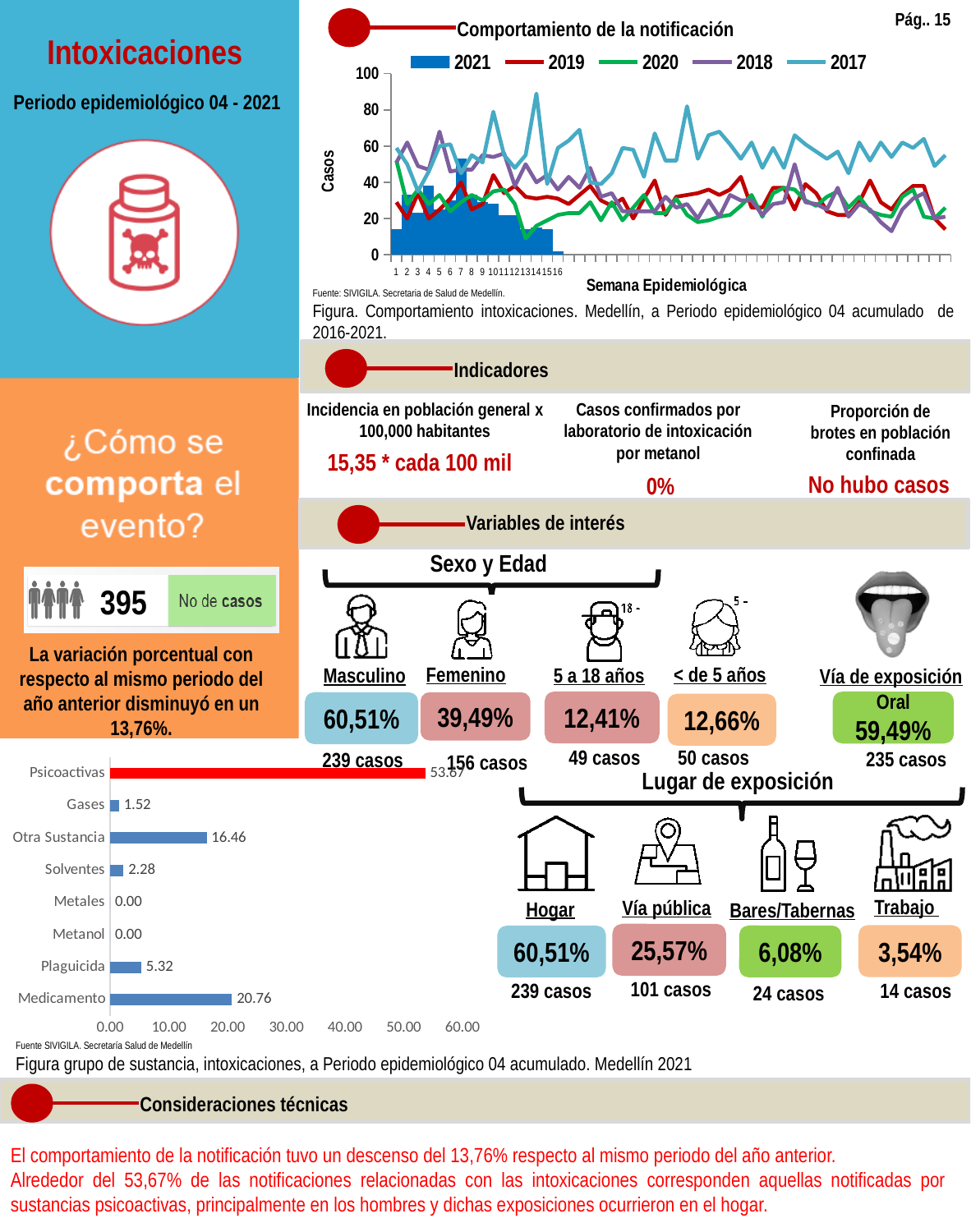
In the bottom bar chart of substance groups, which is larger, Gases or Solventes? Solventes In the bottom bar chart of substance groups, what is the value for Medicamento? 20.76 What kind of chart is the bottom chart of substance groups? Bar chart In the bottom bar chart of substance groups, which category has the highest value? Psicoactivas In the bottom bar chart of substance groups, what is the difference between Otra Sustancia and Solventes? 14.18 In the bottom bar chart of substance groups, how many categories are shown? 8 In the bottom bar chart of substance groups, which categories have a value of 0.00? Metales and Metanol In the top chart 'Comportamiento de la notificación', how many series does the legend list? 5 In the top chart 'Comportamiento de la notificación', what is the label of the y axis? Casos In the top chart 'Comportamiento de la notificación', is the value for 2021 at week 16 greater or less than 20? less In the bottom bar chart of substance groups, what is the value for Psicoactivas? 53.67 In the bottom bar chart of substance groups, what is the value for Plaguicida? 5.32